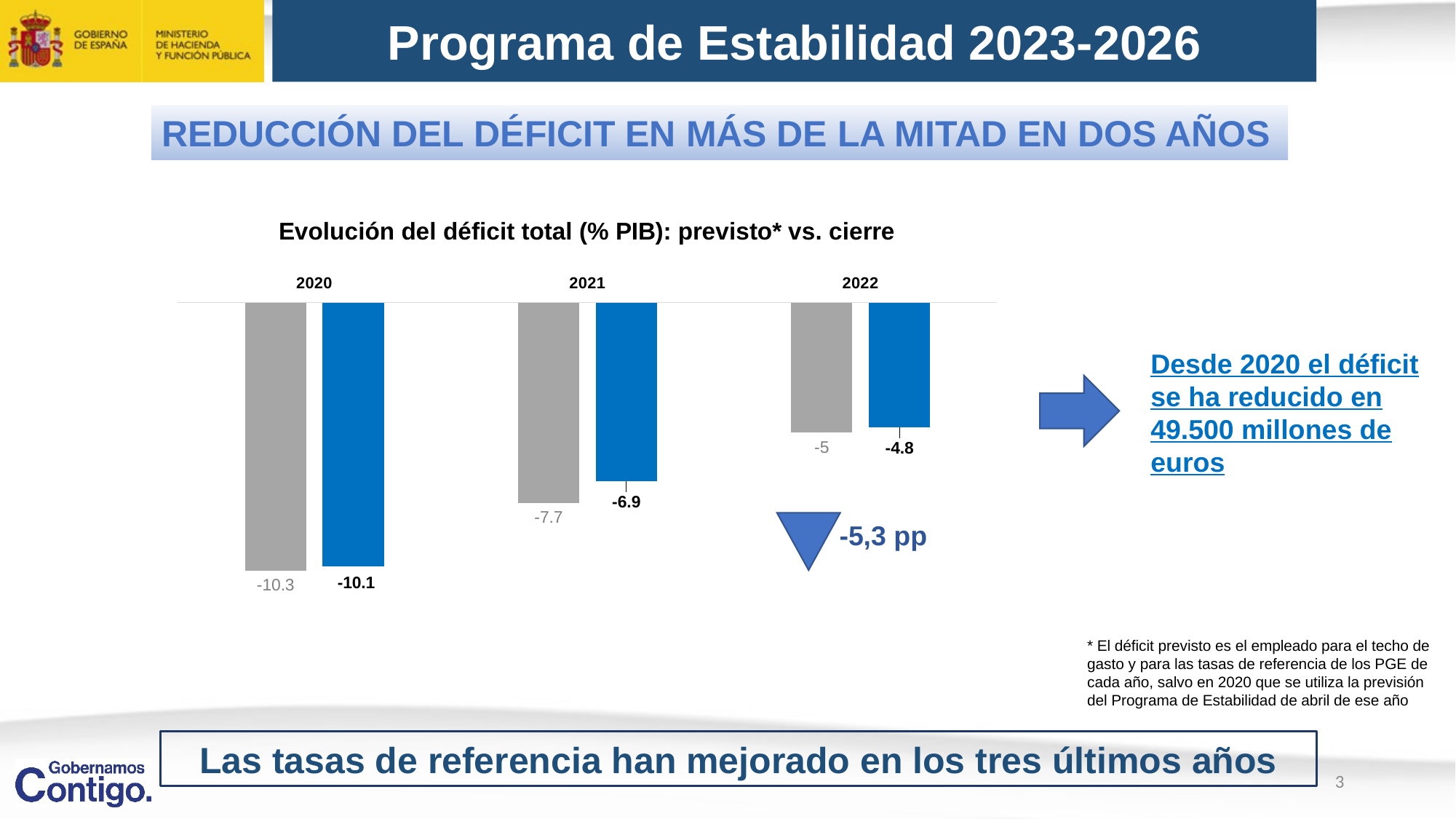
What is the value of the grey bar for 2022? -5 What kind of chart is shown on the slide? Bar chart What is the title of the chart? Evolución del déficit total (% PIB): previsto* vs. cierre What is the value of the blue bar for 2021? -6.9 What is the value of the blue bar for 2022? -4.8 What is the difference between the blue bar for 2020 and the blue bar for 2022? 5.3 What is the difference between the grey bar and the blue bar for 2021? 0.8 What is the value of the grey bar for 2020? -10.3 What is the value of the grey bar for 2021? -7.7 How many years are shown on the chart? 3 Do the blue bars get shorter or longer from 2020 to 2022? Shorter Which year has the largest deficit among the blue bars? 2020